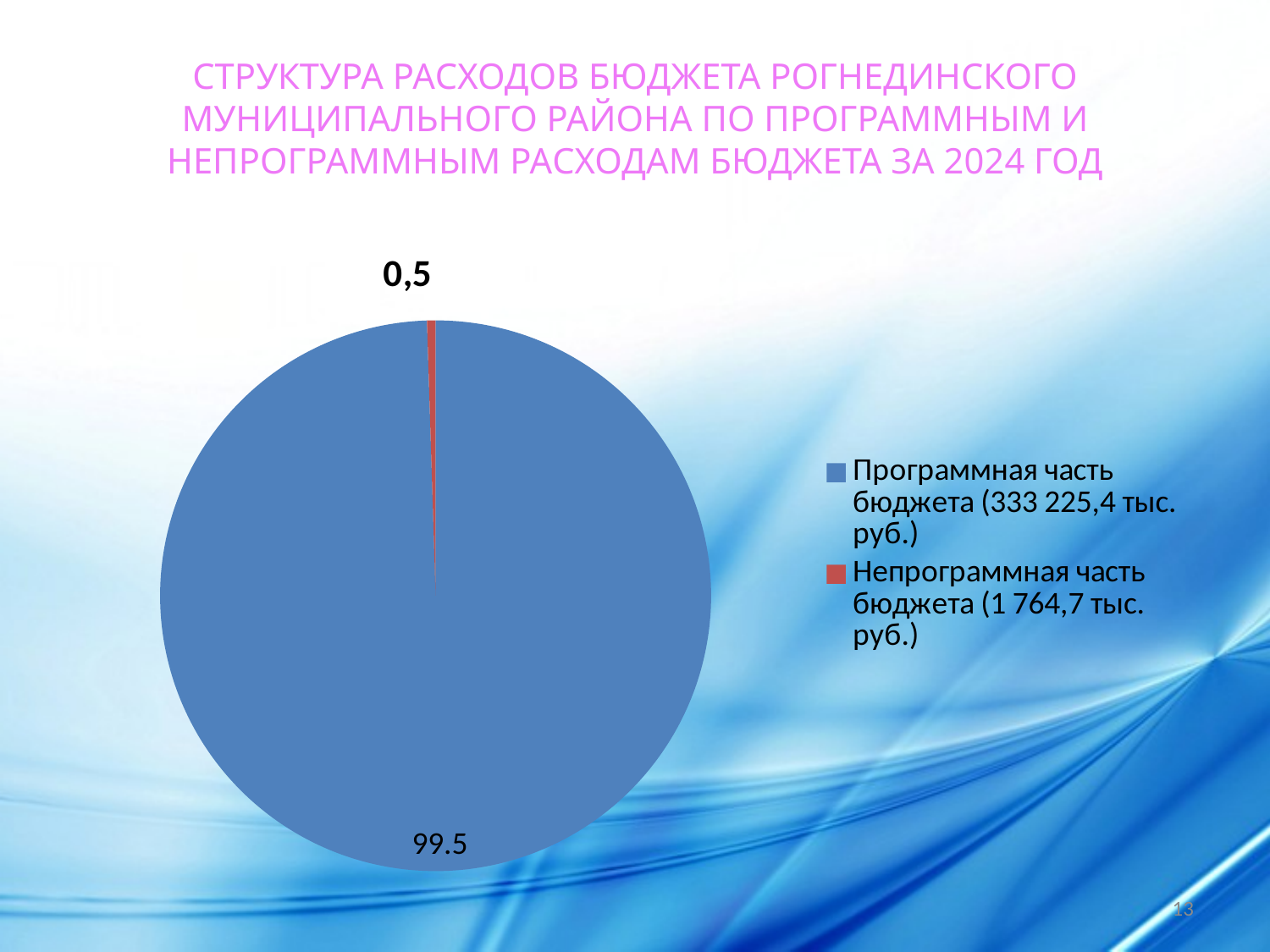
What value is labelled on the slice for Непрограммная часть бюджета? 0,5 Which is larger, the slice for Программная часть бюджета or the slice for Непрограммная часть бюджета? Программная часть бюджета What amount in тыс. руб. does the legend give for Непрограммная часть бюджета? 1 764,7 тыс. руб. What amount in тыс. руб. does the legend give for Программная часть бюджета? 333 225,4 тыс. руб. How many slices does the pie chart have? 2 How many entries does the legend list? 2 What value is labelled on the slice for Программная часть бюджета? 99.5 Which slice of the pie is the largest? Программная часть бюджета What is the total of the two labelled slice values? 100 Which slice of the pie is the smallest? Непрограммная часть бюджета What kind of chart is shown on the slide? pie chart What is the difference between the labelled values of the two slices (99.5 and 0,5)? 99